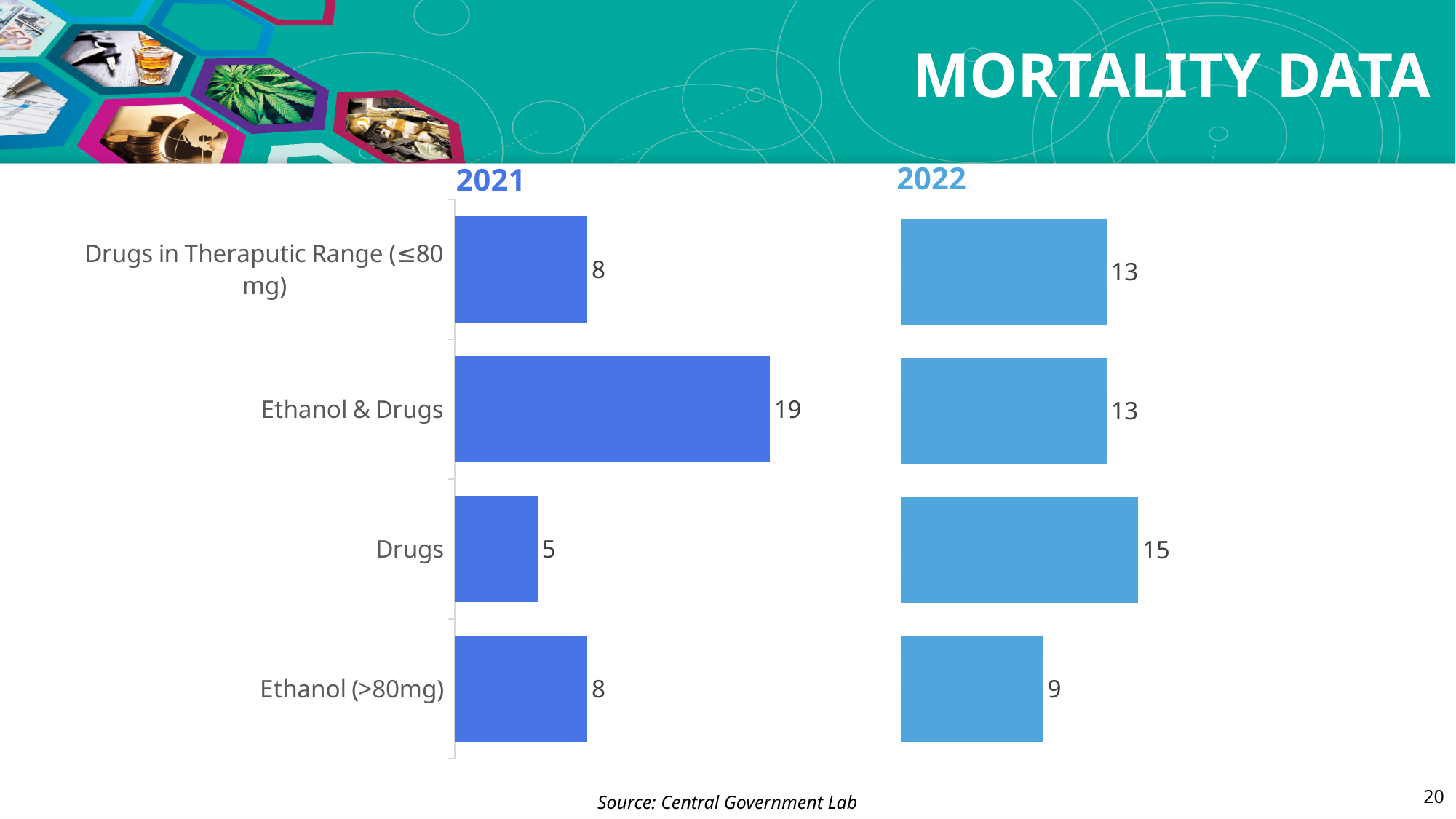
In the 2022 chart, what is the value for Drugs? 15 Is the value for Drugs larger in the 2021 chart or the 2022 chart? 2022 In the 2021 chart, what is the value for Ethanol & Drugs? 19 What type of chart is used to show the 2022 data? Bar chart In the 2021 chart, which category has the lowest value? Drugs In the 2022 chart, which category has the lowest value? Ethanol (>80mg) In the 2022 chart, which category has the highest value? Drugs What is the difference between the Ethanol & Drugs value in the 2021 chart and in the 2022 chart? 6 In the 2022 chart, what is the value for Ethanol (>80mg)? 9 How many categories are shown in the 2021 chart? 4 In the 2021 chart, which category has the highest value? Ethanol & Drugs In the 2021 chart, what is the value for Drugs in Theraputic Range (≤80 mg)? 8